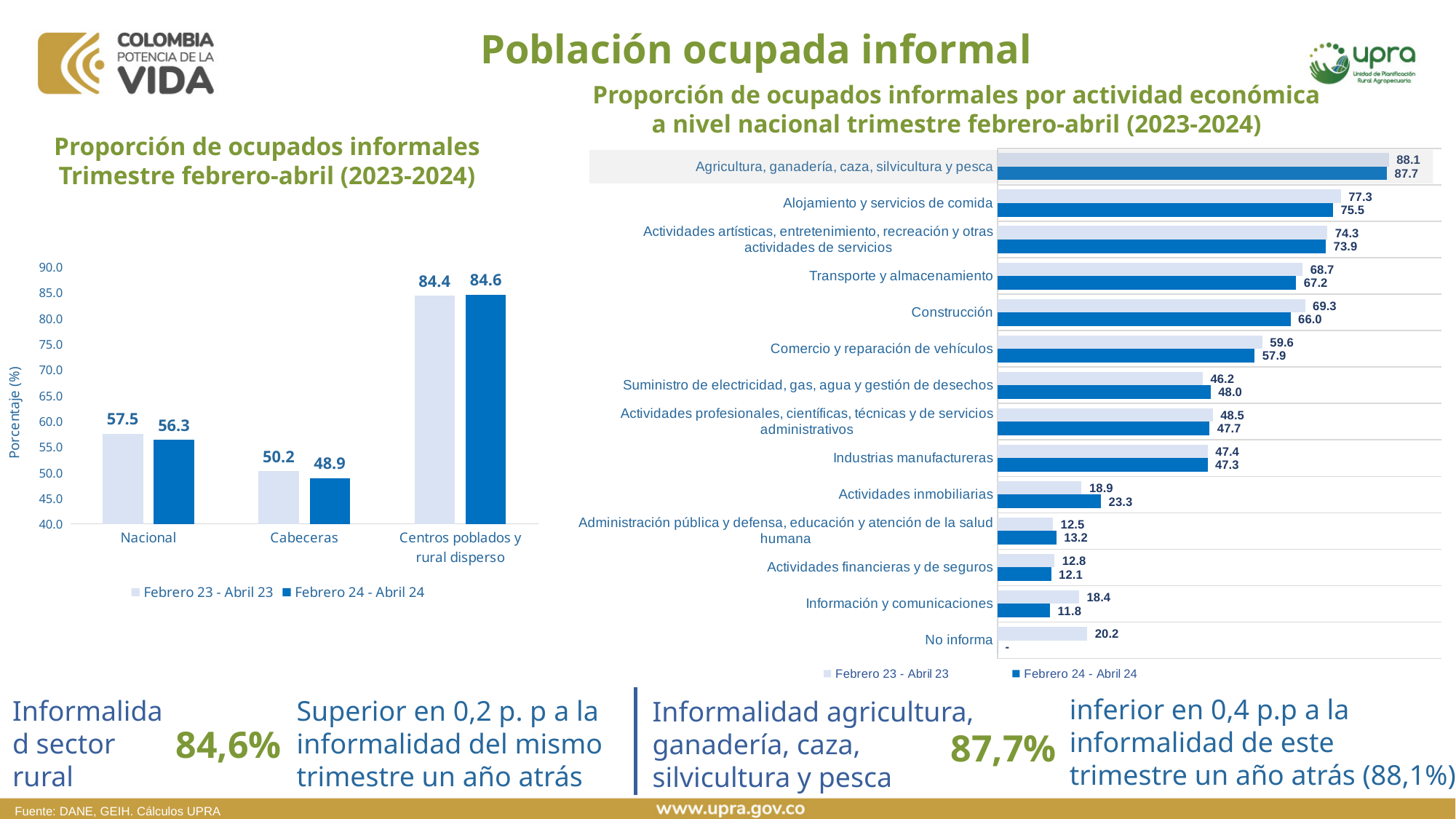
In the left chart (Proporción de ocupados informales Trimestre febrero-abril), what is the value for Cabeceras in the Febrero 23 - Abril 23 series? 50.2 In the right chart (Proporción de ocupados informales por actividad económica), what is the Febrero 24 - Abril 24 value for Construcción? 66.0 How many series does the legend of the right chart (Proporción de ocupados informales por actividad económica) list? 2 In the right chart (Proporción de ocupados informales por actividad económica), which activity has the lowest Febrero 24 - Abril 24 value among those with a printed value? Información y comunicaciones What type of chart is the left chart (Proporción de ocupados informales Trimestre febrero-abril)? Bar chart In the left chart (Proporción de ocupados informales Trimestre febrero-abril), which category has the highest value in the Febrero 24 - Abril 24 series? Centros poblados y rural disperso In the left chart (Proporción de ocupados informales Trimestre febrero-abril), what is the value for Nacional in the Febrero 24 - Abril 24 series? 56.3 In the right chart (Proporción de ocupados informales por actividad económica), what is the Febrero 23 - Abril 23 value for Actividades inmobiliarias? 18.9 In the right chart (Proporción de ocupados informales por actividad económica), which activity has the highest Febrero 24 - Abril 24 value? Agricultura, ganadería, caza, silvicultura y pesca In the right chart (Proporción de ocupados informales por actividad económica), which is larger for Suministro de electricidad, gas, agua y gestión de desechos: the Febrero 23 - Abril 23 value or the Febrero 24 - Abril 24 value? Febrero 24 - Abril 24 In the left chart (Proporción de ocupados informales Trimestre febrero-abril), what is the difference between the Febrero 23 - Abril 23 and Febrero 24 - Abril 24 values for Nacional? 1.2 In the left chart (Proporción de ocupados informales Trimestre febrero-abril), how many categories are shown on the x axis? 3